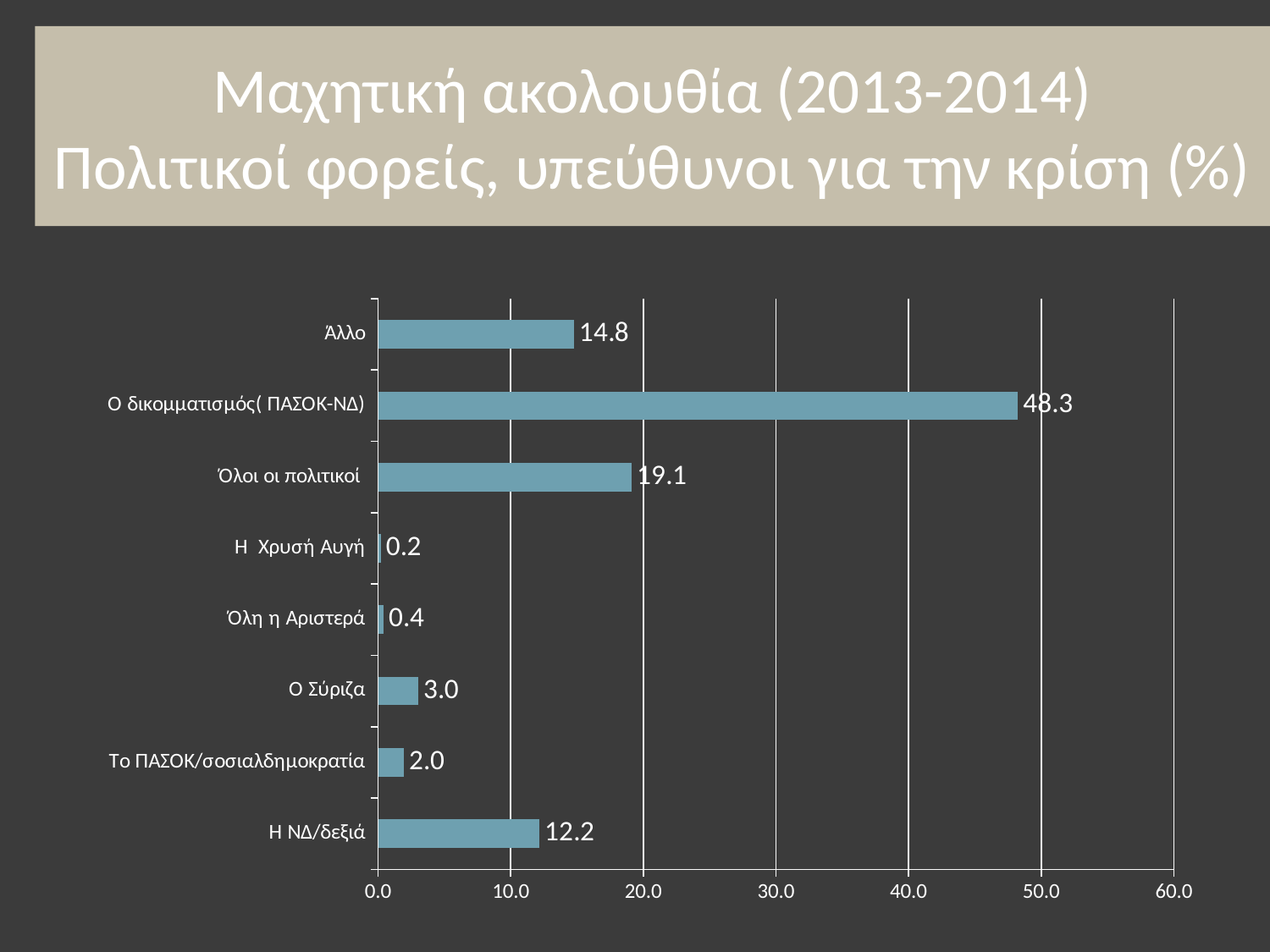
What is the value for Ο δικομματισμός( ΠΑΣΟΚ-ΝΔ)? 48.3 What is the value for Ο Σύριζα? 3.0 Is the value for Όλοι οι πολιτικοί greater or less than 20.0? less What is the value for Όλοι οι πολιτικοί? 19.1 What is the value for Η ΝΔ/δεξιά? 12.2 What kind of chart is shown on the slide? bar chart Which category has the highest value? Ο δικομματισμός( ΠΑΣΟΚ-ΝΔ) What is the difference between the values for Ο δικομματισμός( ΠΑΣΟΚ-ΝΔ) and Όλοι οι πολιτικοί? 29.2 Which is larger, the value for Άλλο or the value for Η ΝΔ/δεξιά? Άλλο How many categories are shown in the chart? 8 What is the maximum value shown on the x axis? 60.0 Which category has the lowest value? Η Χρυσή Αυγή